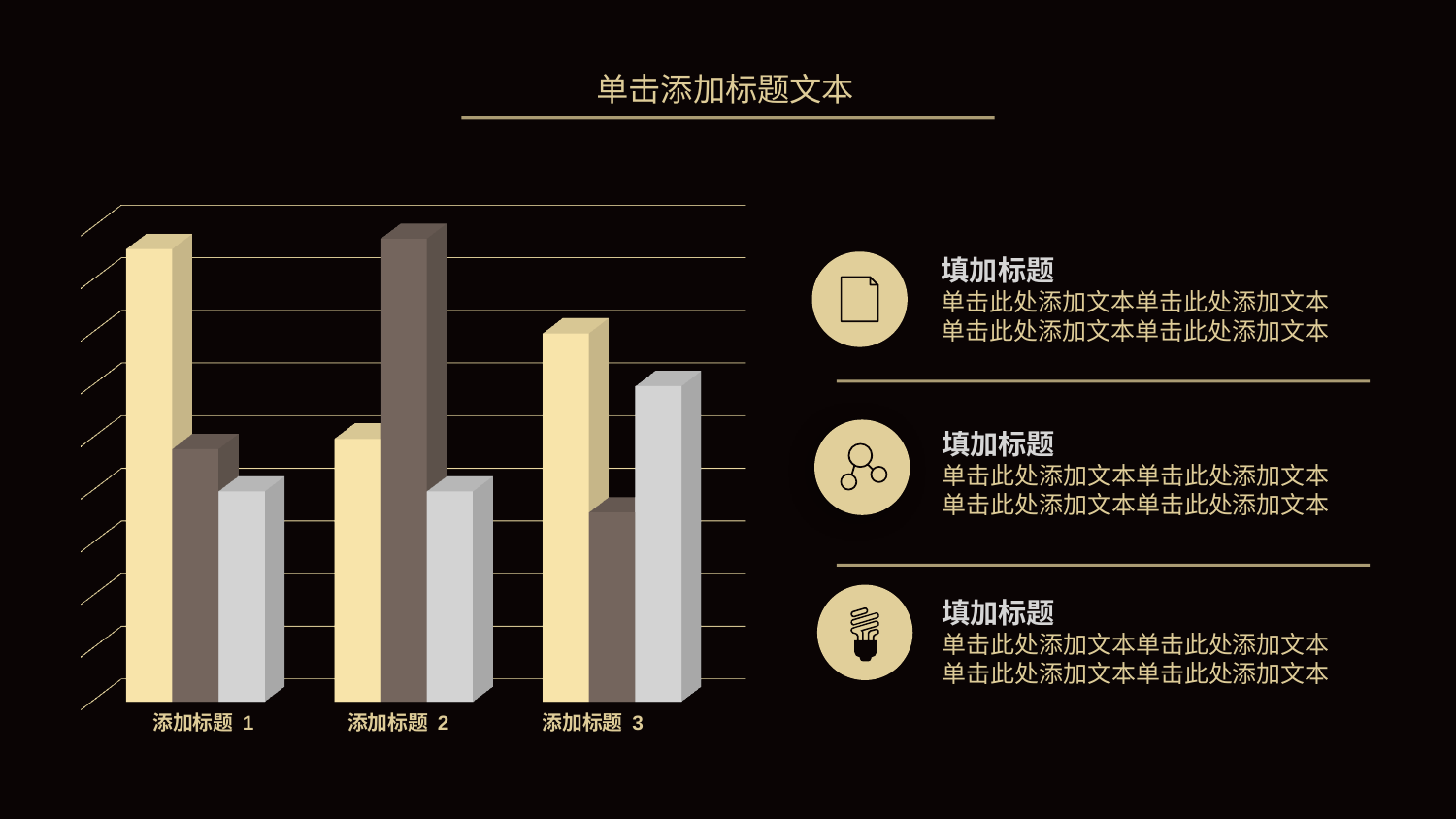
What kind of chart is shown on the left of the slide? bar chart In category 添加标题 3, which is taller: the gray bar or the brown bar? the gray bar In category 添加标题 1, which is taller: the yellow bar or the brown bar? the yellow bar Which category has the shortest brown bar? 添加标题 3 How many categories are shown along the x axis of the bar chart? 3 Which category has the tallest gray bar? 添加标题 3 Which category has the tallest brown bar? 添加标题 2 In category 添加标题 2, which is taller: the brown bar or the yellow bar? the brown bar What is the title text at the top of the slide? 单击添加标题文本 Which category has the tallest yellow bar? 添加标题 1 How many bars are plotted for each category in the bar chart? 3 Which category has the shortest yellow bar? 添加标题 2